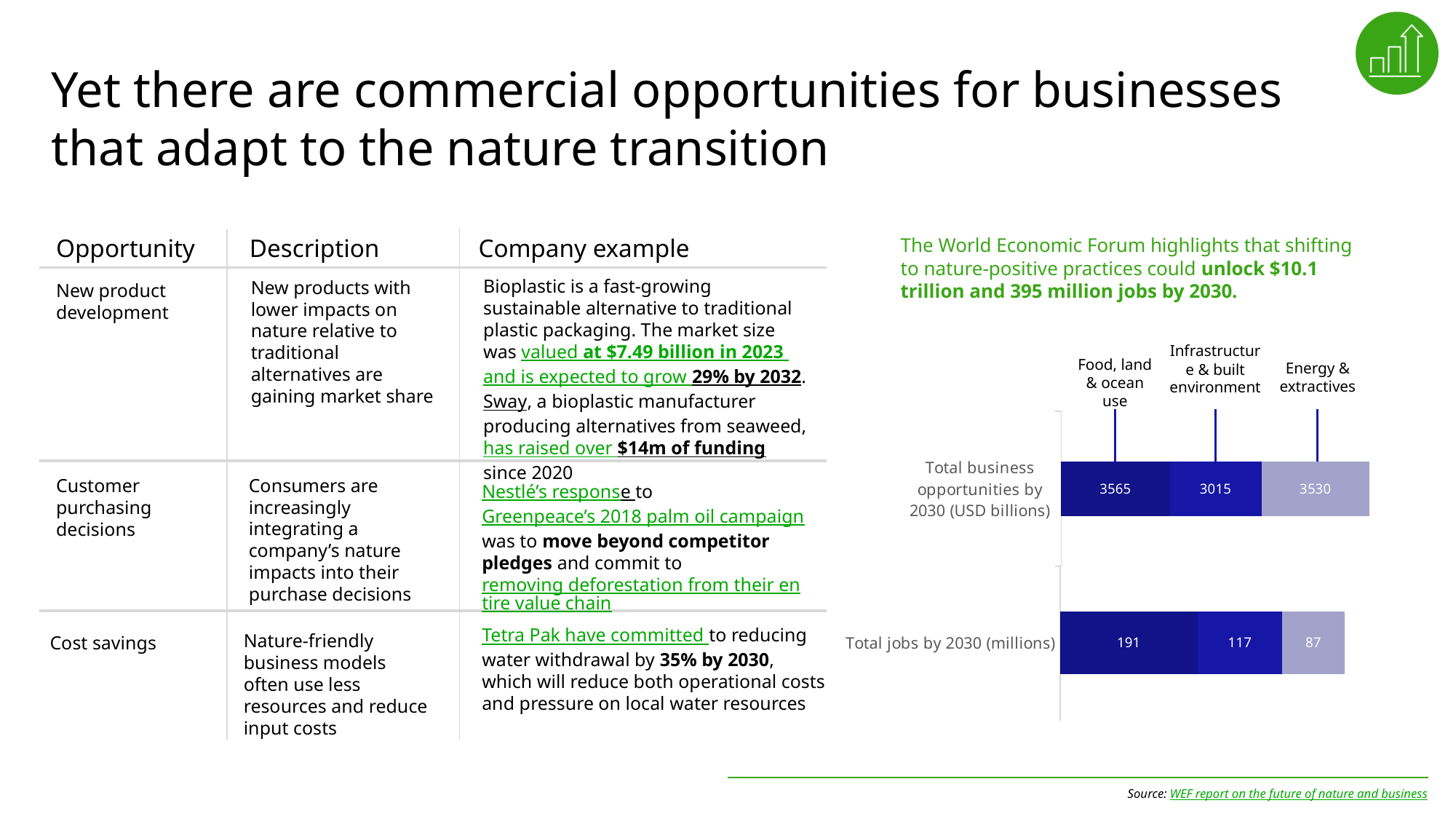
What is the difference between Food, land & ocean use and Energy & extractives in the Total jobs by 2030 (millions) bar? 104 What is the total of the Total jobs by 2030 (millions) bar? 395 What is the value for Energy & extractives in the Total business opportunities by 2030 (USD billions) bar? 3530 What kind of chart is shown on the right of the slide? Stacked bar chart How many bars are plotted in the chart? 2 Which segment is the largest in the Total jobs by 2030 (millions) bar? Food, land & ocean use What is the value for Infrastructure & built environment in the Total jobs by 2030 (millions) bar? 117 What is the value for Food, land & ocean use in the Total business opportunities by 2030 (USD billions) bar? 3565 What is the total of the Total business opportunities by 2030 (USD billions) bar? 10110 How many series (segments) does the chart show per bar? 3 In the Total business opportunities by 2030 (USD billions) bar, which is larger: Food, land & ocean use or Infrastructure & built environment? Food, land & ocean use Which segment is the smallest in the Total business opportunities by 2030 (USD billions) bar? Infrastructure & built environment